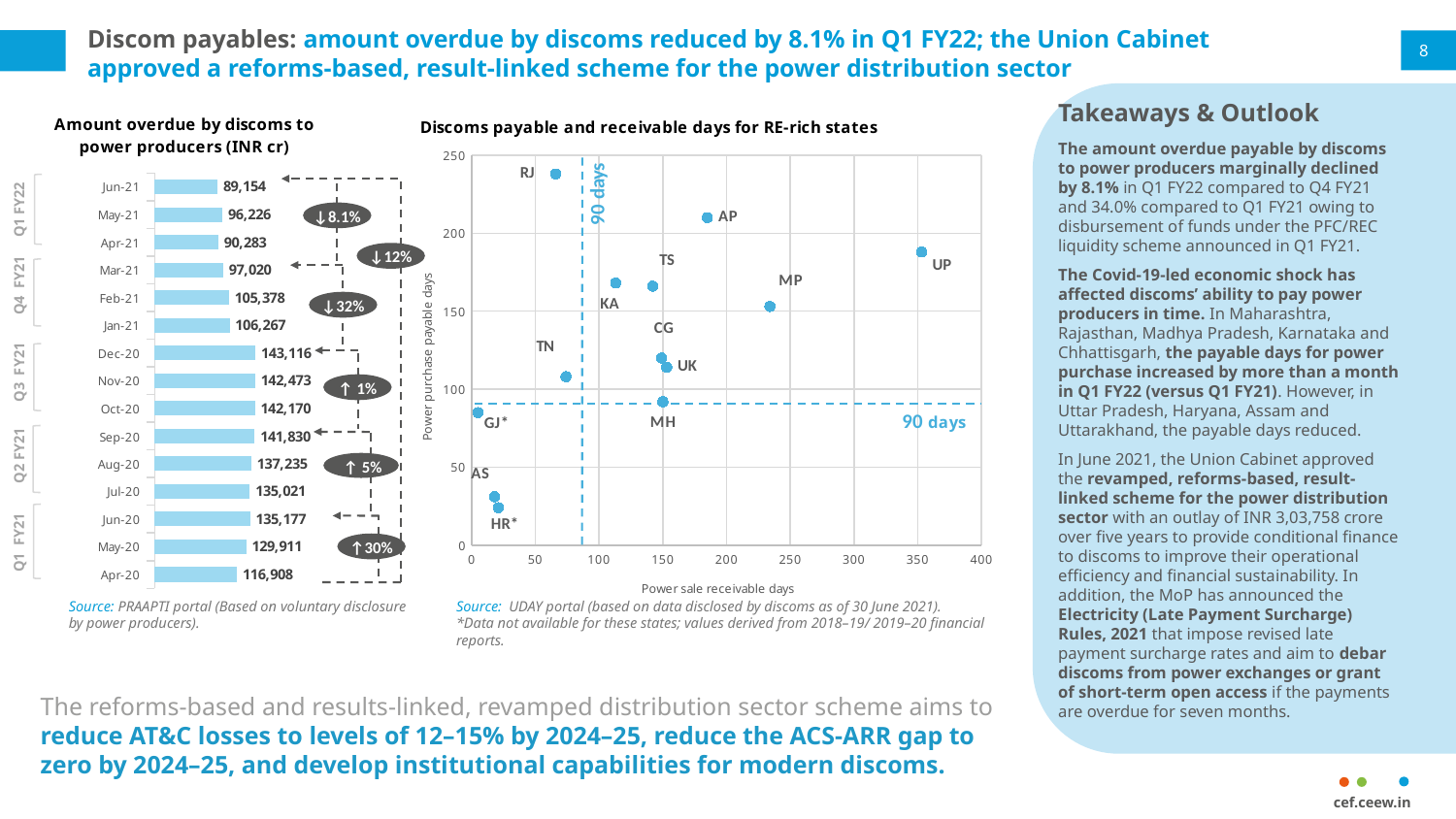
What kind of chart is 'Discoms payable and receivable days for RE-rich states'? Scatter chart In the chart 'Amount overdue by discoms to power producers (INR cr)', what is the value for Jun-21? 89,154 What kind of chart is 'Amount overdue by discoms to power producers (INR cr)'? Bar chart In the chart 'Amount overdue by discoms to power producers (INR cr)', which month has the lowest value? Jun-21 In the chart 'Discoms payable and receivable days for RE-rich states', is the power sale receivable days value for UP greater or less than 300? greater In the chart 'Amount overdue by discoms to power producers (INR cr)', which is larger, the value for Apr-21 or the value for May-21? May-21 In the chart 'Amount overdue by discoms to power producers (INR cr)', what is the value for Dec-20? 143,116 How many states are plotted in the chart 'Discoms payable and receivable days for RE-rich states'? 13 In the chart 'Amount overdue by discoms to power producers (INR cr)', which month has the highest value? Dec-20 How many months are shown in the chart 'Amount overdue by discoms to power producers (INR cr)'? 15 In the chart 'Discoms payable and receivable days for RE-rich states', is the power purchase payable days value for RJ greater or less than 200? greater In the chart 'Amount overdue by discoms to power producers (INR cr)', what is the difference between the values for Jan-21 and Feb-21? 889